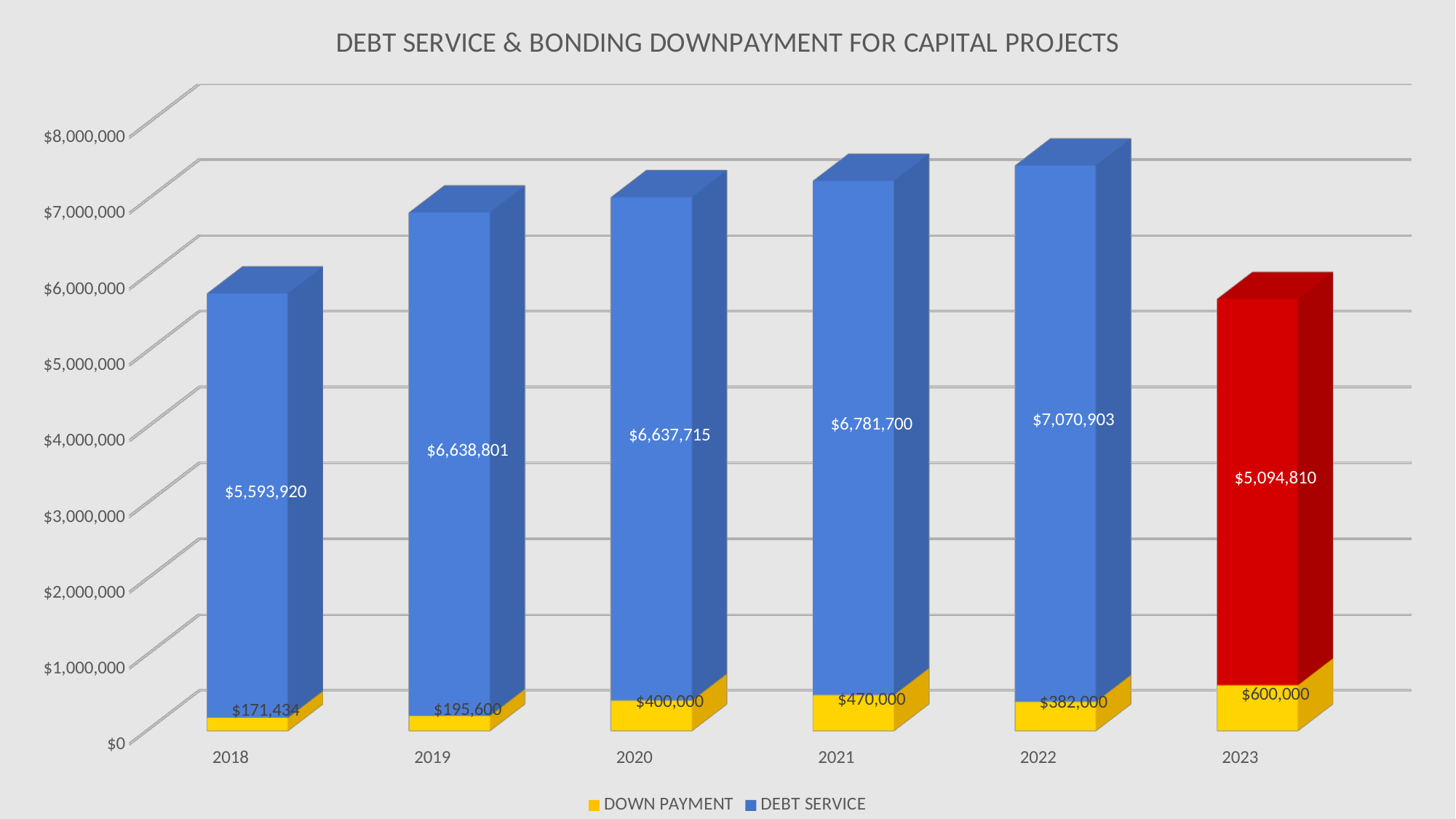
What is the Debt Service value for 2023? $5,094,810 How many years are shown on the x axis? 6 Which year has the highest Down Payment value? 2023 What is the Down Payment value for 2020? $400,000 How many series does the legend list? 2 Which year has the lowest Down Payment value? 2018 Which year has the highest Debt Service value? 2022 What is the difference between the Debt Service values for 2022 and 2018? $1,476,983 Which is larger, the Down Payment for 2021 or for 2022? 2021 What is the total of the stacked bar for 2023? $5,694,810 What is the Debt Service value for 2021? $6,781,700 What kind of chart is shown on the slide? Stacked bar chart